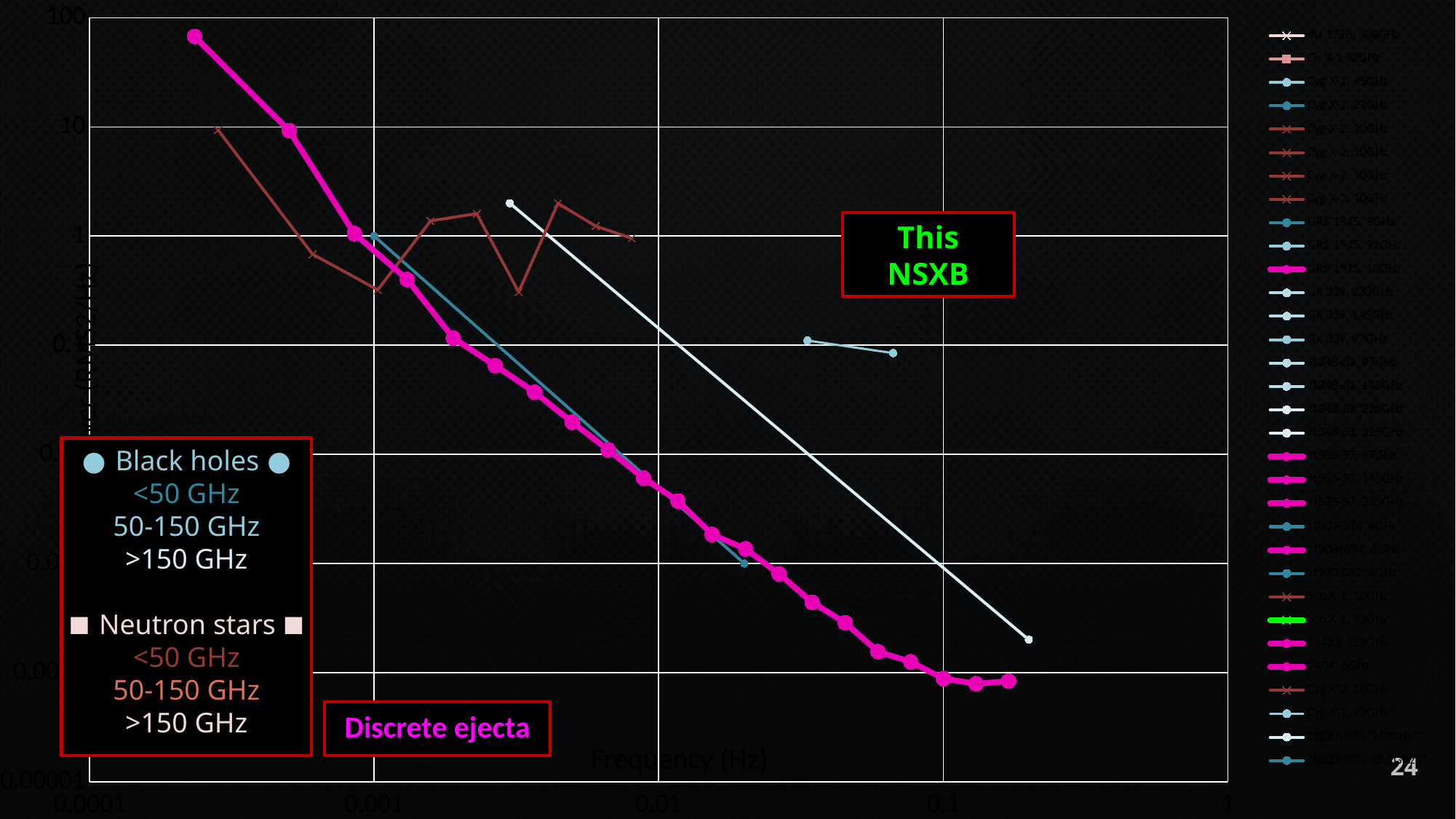
What is the highest value tick label shown on the y axis? 100 Which line reaches the highest value on the chart: the magenta 'Discrete ejecta' line or the brown line? the magenta 'Discrete ejecta' line Does the magenta 'Discrete ejecta' line rise or fall as frequency increases along the x axis? fall What is the lowest frequency tick label shown on the x axis? 0.0001 According to the legend box, which marker shape is used for neutron stars? square Is the value of the rightmost point of the long light-blue line (ending near 0.2 Hz) greater or less than 0.01? less Is the value of the first (leftmost) point of the magenta 'Discrete ejecta' line greater or less than 10? greater What kind of chart is shown on the slide? line chart What is the label of the x axis? Frequency (Hz) Is the value of the last (rightmost) point of the magenta 'Discrete ejecta' line greater or less than 0.01? less